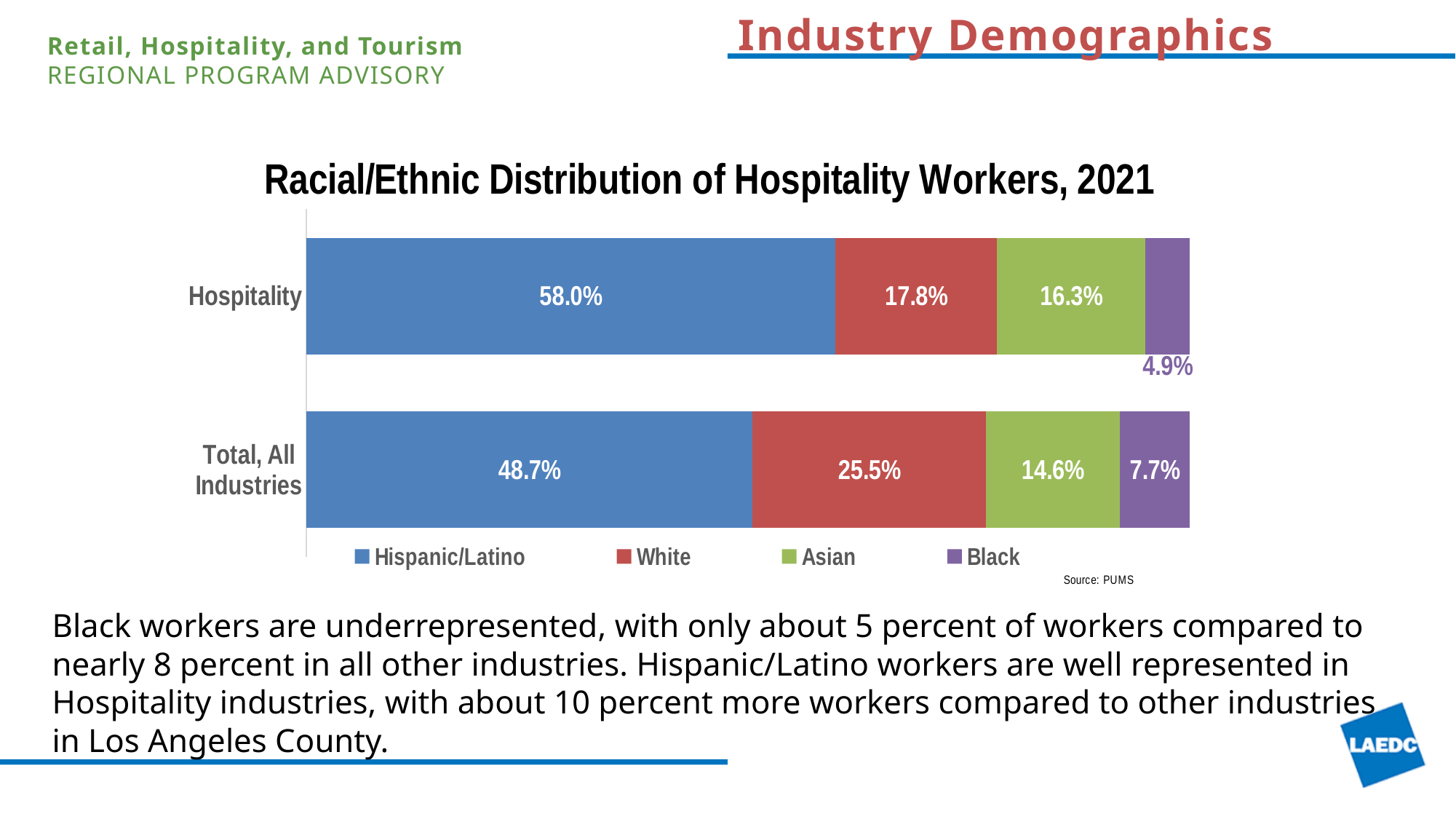
What is the Black share of Hospitality workers? 4.9% How many categories (bars) are shown on the chart? 2 What type of chart is shown on the slide? Stacked bar chart What is the Asian share for Total, All Industries? 14.6% Is the White share larger in Hospitality or in Total, All Industries? Total, All Industries Which racial/ethnic group has the smallest share in the Total, All Industries bar? Black How many series does the legend list? 4 How many percentage points higher is the Hispanic/Latino share in Hospitality than in Total, All Industries? 9.3 What is the White share for Total, All Industries? 25.5% What is the difference between the Black share in Total, All Industries and in Hospitality? 2.8 Which racial/ethnic group has the largest share in the Hospitality bar? Hispanic/Latino What is the Hispanic/Latino share of Hospitality workers? 58.0%